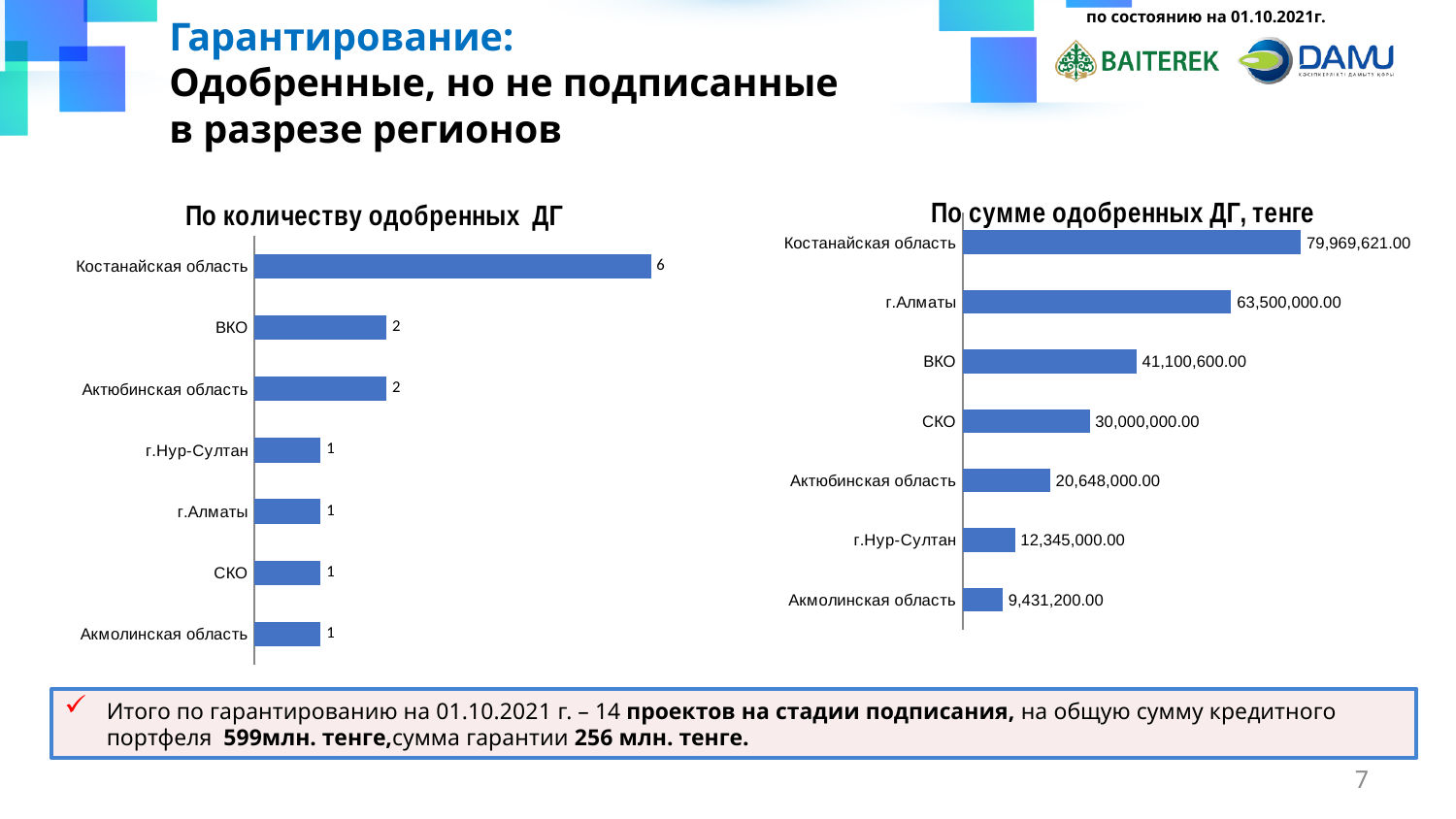
In the chart "По сумме одобренных ДГ, тенге", which is larger: ВКО or СКО? ВКО In the chart "По количеству одобренных ДГ", what is the value for ВКО? 2 What type of chart is "По сумме одобренных ДГ, тенге"? Bar chart In the chart "По сумме одобренных ДГ, тенге", what is the value for г.Алматы? 63,500,000.00 In the chart "По количеству одобренных ДГ", which region has the highest value? Костанайская область In the chart "По количеству одобренных ДГ", what is the value for Костанайская область? 6 In the chart "По количеству одобренных ДГ", how many categories are shown? 7 In the chart "По количеству одобренных ДГ", what is the difference between Костанайская область and Актюбинская область? 4 In the chart "По сумме одобренных ДГ, тенге", what is the difference between Костанайская область and г.Алматы? 16,469,621.00 In the chart "По сумме одобренных ДГ, тенге", what is the value for Акмолинская область? 9,431,200.00 In the chart "По сумме одобренных ДГ, тенге", what is the value for г.Нур-Султан? 12,345,000.00 In the chart "По сумме одобренных ДГ, тенге", which region has the lowest value? Акмолинская область